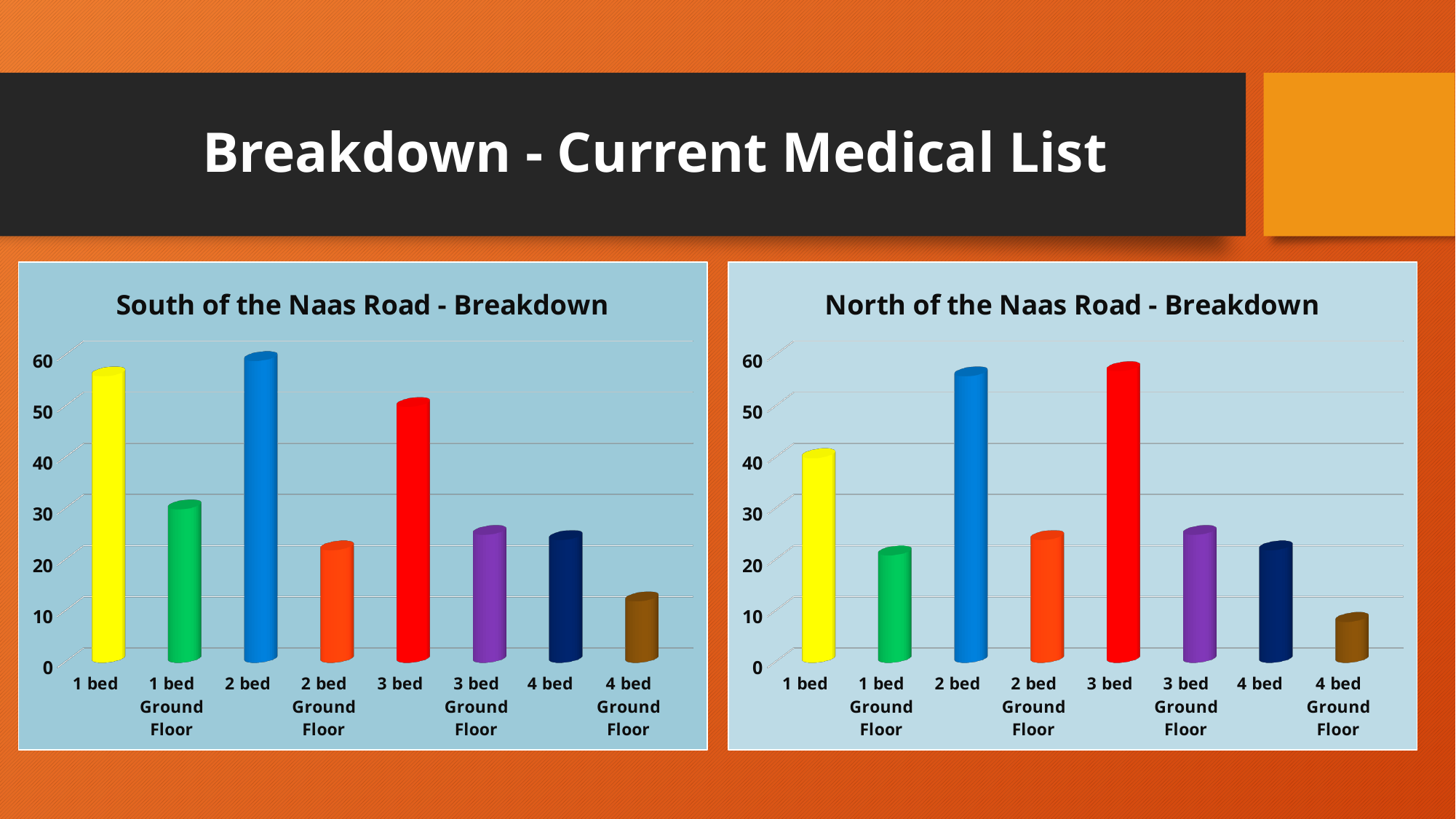
In the 'North of the Naas Road - Breakdown' chart, which is larger, the value for 2 bed or the value for 1 bed? 2 bed What kind of chart is the 'South of the Naas Road - Breakdown' chart? bar chart In the 'South of the Naas Road - Breakdown' chart, how many categories are shown on the x axis? 8 In the 'South of the Naas Road - Breakdown' chart, is the value for 2 bed Ground Floor greater or less than 30? less In the 'North of the Naas Road - Breakdown' chart, which category has the lowest value? 4 bed Ground Floor In the 'South of the Naas Road - Breakdown' chart, which category has the highest value? 2 bed In the 'South of the Naas Road - Breakdown' chart, which is larger, the value for 3 bed or the value for 4 bed? 3 bed In the 'South of the Naas Road - Breakdown' chart, is the value for 1 bed greater or less than 50? greater In the 'South of the Naas Road - Breakdown' chart, which category has the lowest value? 4 bed Ground Floor In the 'North of the Naas Road - Breakdown' chart, is the value for 1 bed greater or less than 50? less What is the title of the chart on the right side of the slide? North of the Naas Road - Breakdown